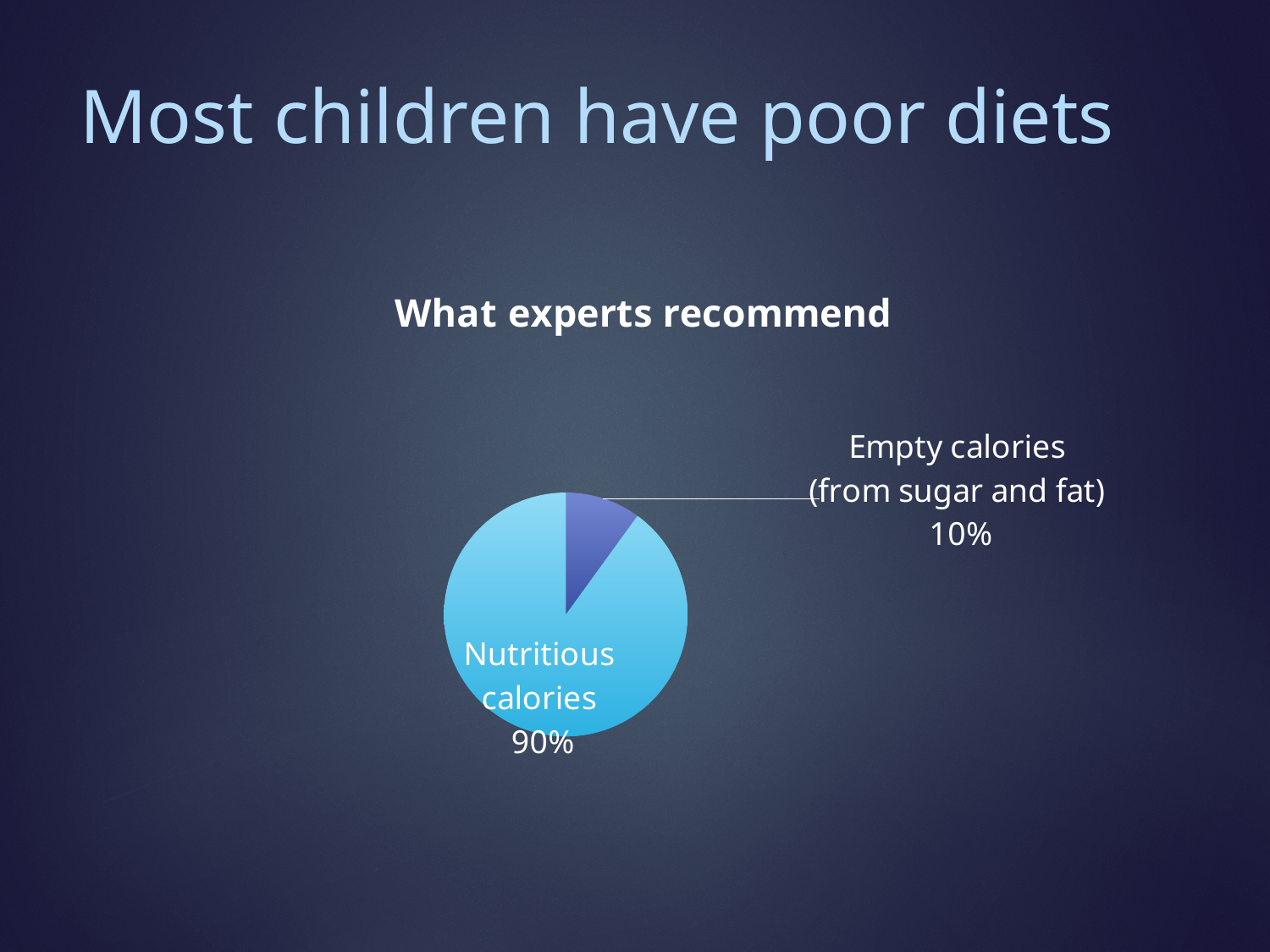
What share of the pie is Nutritious calories? 90% What is the difference in percentage points between the Nutritious calories slice and the Empty calories slice? 80 What is the chart's title? What experts recommend What share of the pie is Empty calories (from sugar and fat)? 10% Which is larger, the Nutritious calories slice or the Empty calories slice? Nutritious calories How many slices does the pie chart have? 2 Which slice of the pie is the smallest? Empty calories (from sugar and fat) Which slice of the pie is the largest? Nutritious calories What colour is the Empty calories slice? dark blue/purple What kind of chart is shown on the slide? pie chart